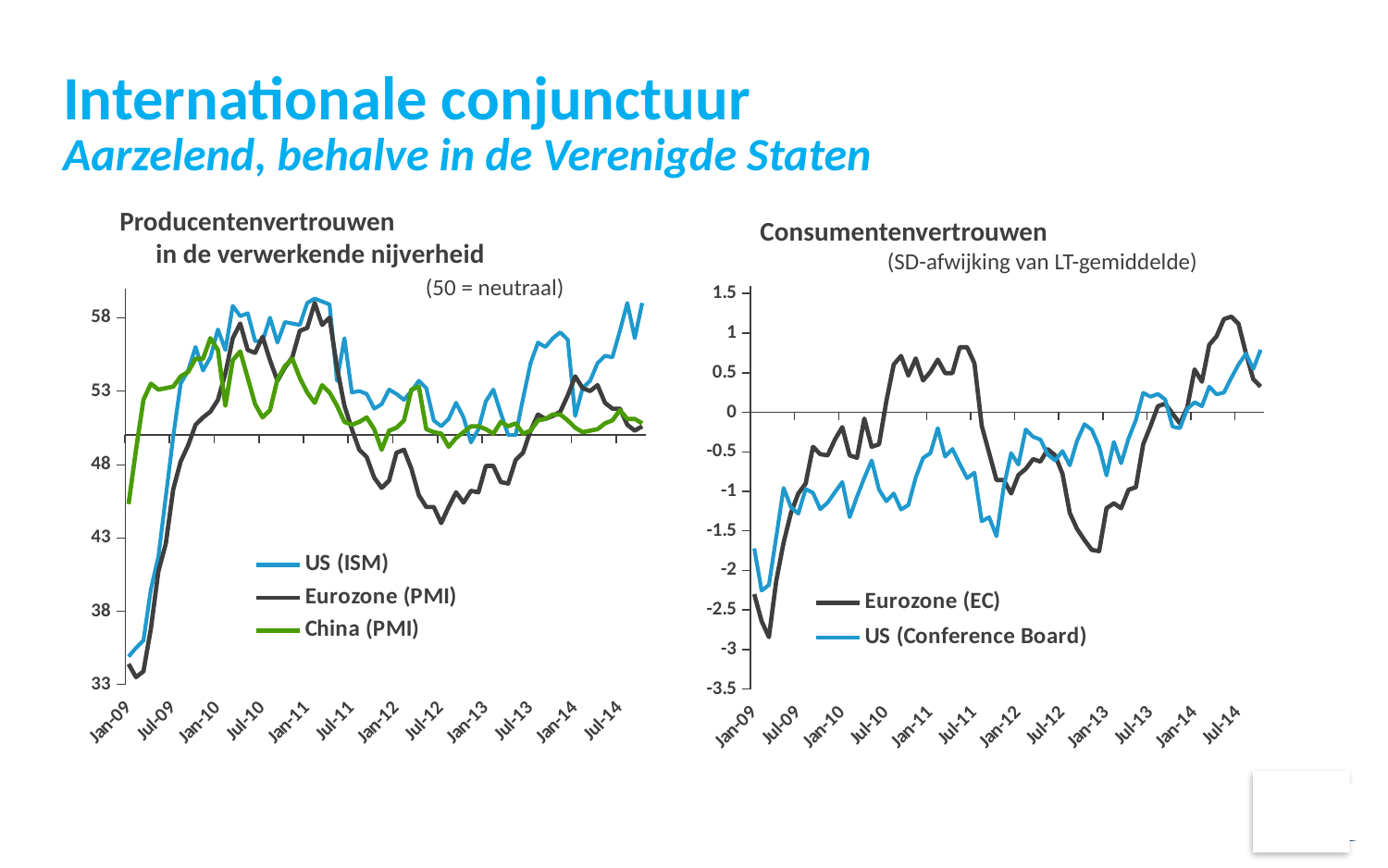
In the left chart, 'Producentenvertrouwen in de verwerkende nijverheid', is the value for Eurozone (PMI) at Jan-09 greater or less than 38? less In the left chart, 'Producentenvertrouwen in de verwerkende nijverheid', which is larger at Jan-09: China (PMI) or Eurozone (PMI)? China (PMI) In the right chart, 'Consumentenvertrouwen', which two series are shown in the legend? Eurozone (EC) and US (Conference Board) In the left chart, 'Producentenvertrouwen in de verwerkende nijverheid', is the value for US (ISM) at Jul-14 greater or less than 53? greater In the right chart, 'Consumentenvertrouwen', which is larger at Jan-13: US (Conference Board) or Eurozone (EC)? US (Conference Board) How many series does the legend of the left chart, 'Producentenvertrouwen in de verwerkende nijverheid', list? 3 What kind of chart is the left chart, 'Producentenvertrouwen in de verwerkende nijverheid'? line chart In the left chart, 'Producentenvertrouwen in de verwerkende nijverheid', which series is drawn in green? China (PMI) In the right chart, 'Consumentenvertrouwen', is the value for Eurozone (EC) at Jan-09 greater or less than -2? less How many series does the legend of the right chart, 'Consumentenvertrouwen', list? 2